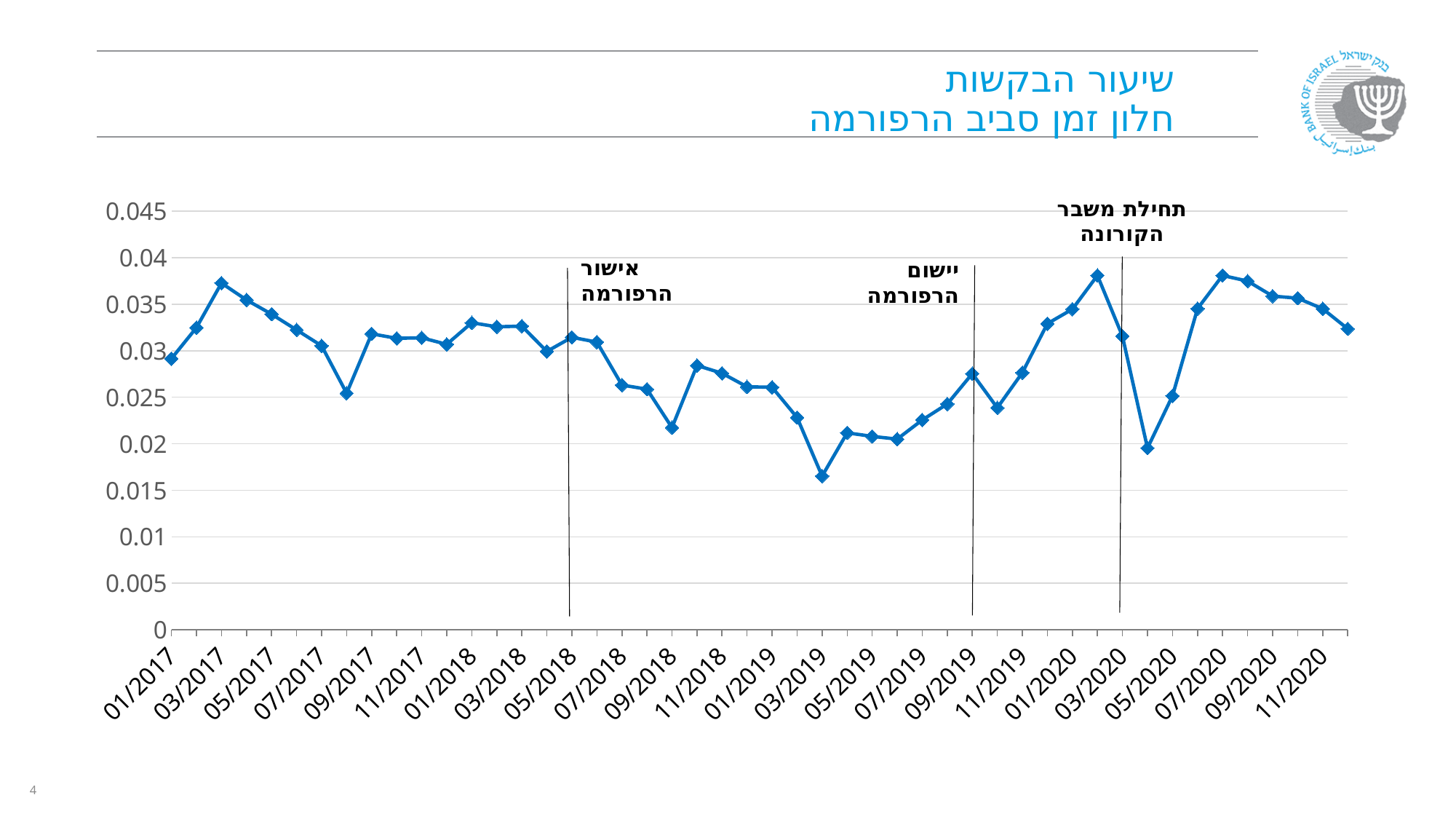
Do the values rise or fall from 03/2019 to 02/2020? rise Is the value for 09/2018 greater or less than 0.025? less Which month has the lowest value on the chart? 03/2019 Which is larger, the value for 02/2020 or the value for 04/2020? 02/2020 Is the value for 03/2017 greater or less than 0.035? greater Do the values rise or fall from 07/2020 to 12/2020? fall Is the value for 08/2017 greater or less than 0.03? less How many vertical annotation lines mark events on the chart? 3 Which is larger, the value for 03/2017 or the value for 03/2019? 03/2017 What kind of chart is shown on the slide? line chart